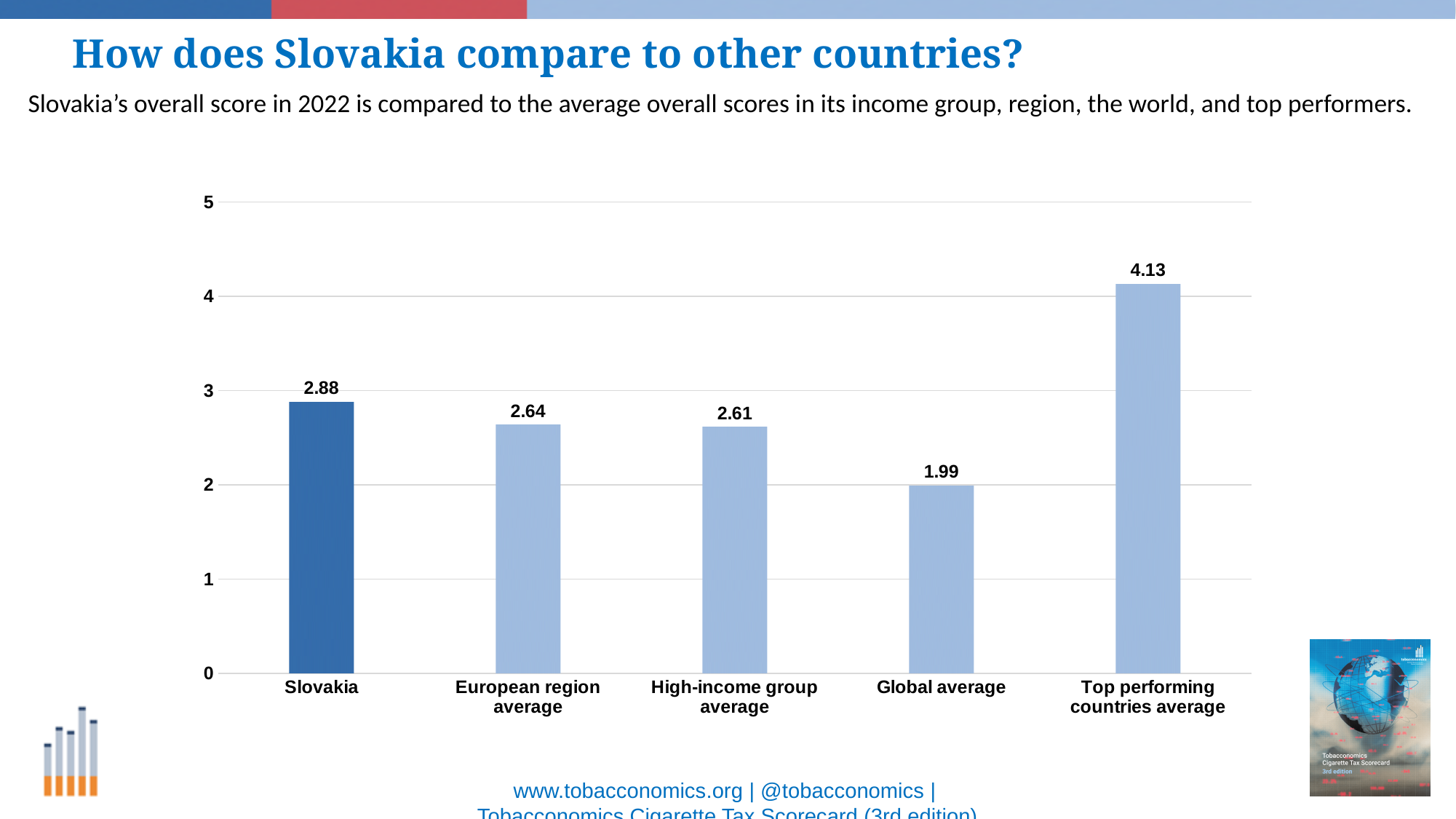
Which is larger, Slovakia's score or the European region average? Slovakia Which category has the highest value? Top performing countries average How many categories are shown on the chart? 5 What kind of chart is shown on the slide? Bar chart What is the value shown for the Top performing countries average? 4.13 What is the overall score shown for Slovakia? 2.88 What is the difference between the Top performing countries average and Slovakia's score? 1.25 What is the value shown for the Global average? 1.99 What is the value shown for the European region average? 2.64 Which category has the lowest value? Global average What is the value shown for the High-income group average? 2.61 What is the difference between Slovakia's score and the Global average? 0.89